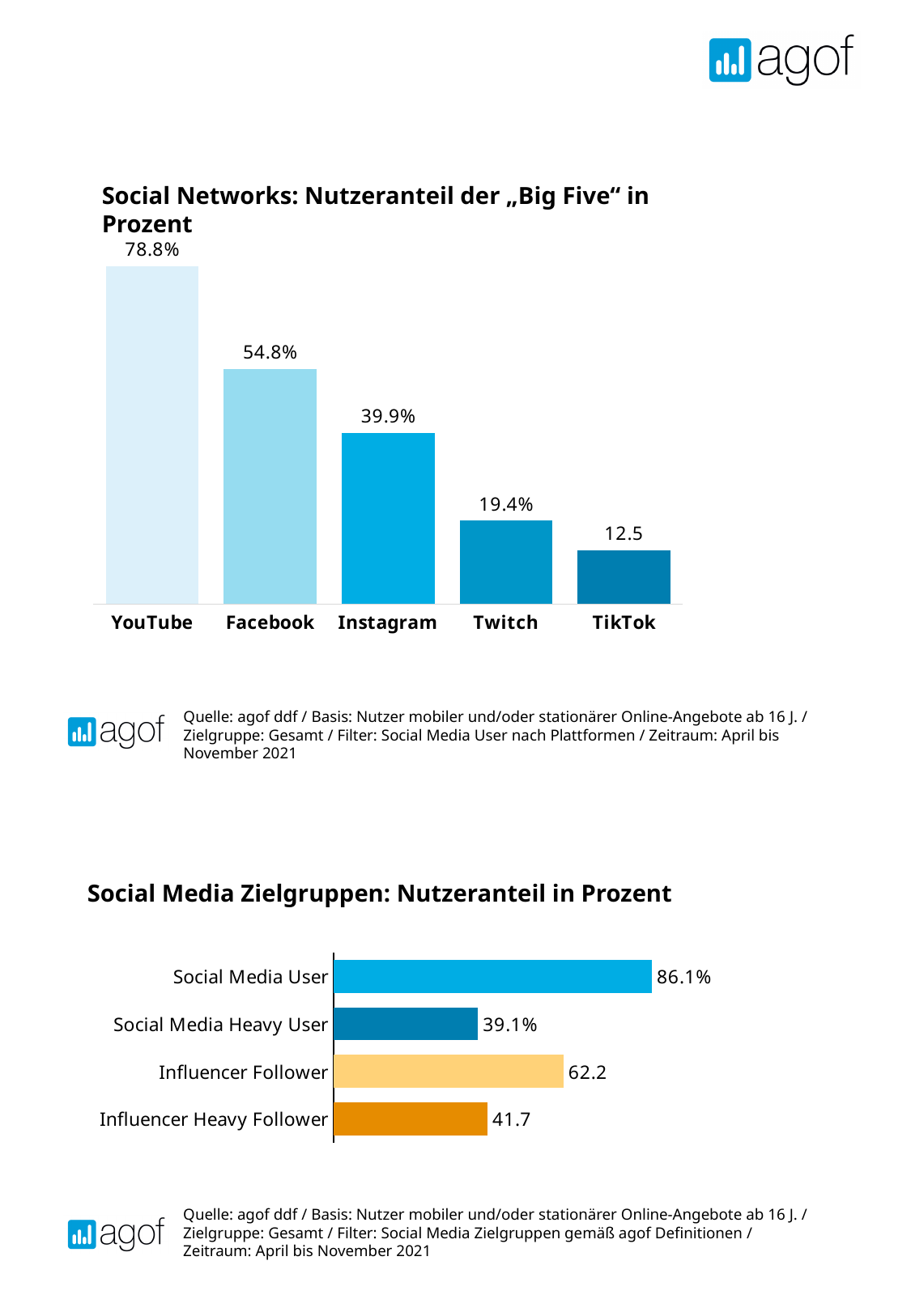
In the 'Social Media Zielgruppen: Nutzeranteil in Prozent' chart, which is larger: Influencer Heavy Follower or Social Media Heavy User? Influencer Heavy Follower In the 'Social Media Zielgruppen: Nutzeranteil in Prozent' chart, what is the value for Social Media Heavy User? 39.1% In the 'Social Networks: Nutzeranteil der „Big Five“ in Prozent' chart, what is the value for YouTube? 78.8% In the 'Social Networks: Nutzeranteil der „Big Five“ in Prozent' chart, do the values rise or fall from left to right? fall In the 'Social Networks: Nutzeranteil der „Big Five“ in Prozent' chart, what is the difference between YouTube and Facebook? 24.0% In the 'Social Networks: Nutzeranteil der „Big Five“ in Prozent' chart, how many platforms are shown? 5 In the 'Social Networks: Nutzeranteil der „Big Five“ in Prozent' chart, which platform has the lowest value? TikTok In the 'Social Media Zielgruppen: Nutzeranteil in Prozent' chart, what is the difference between Influencer Follower and Influencer Heavy Follower? 20.5 In the 'Social Media Zielgruppen: Nutzeranteil in Prozent' chart, what is the value for Influencer Follower? 62.2 In the 'Social Media Zielgruppen: Nutzeranteil in Prozent' chart, which category has the highest value? Social Media User In the 'Social Networks: Nutzeranteil der „Big Five“ in Prozent' chart, what is the value for Twitch? 19.4% What kind of chart is the 'Social Networks: Nutzeranteil der „Big Five“ in Prozent' chart? bar chart